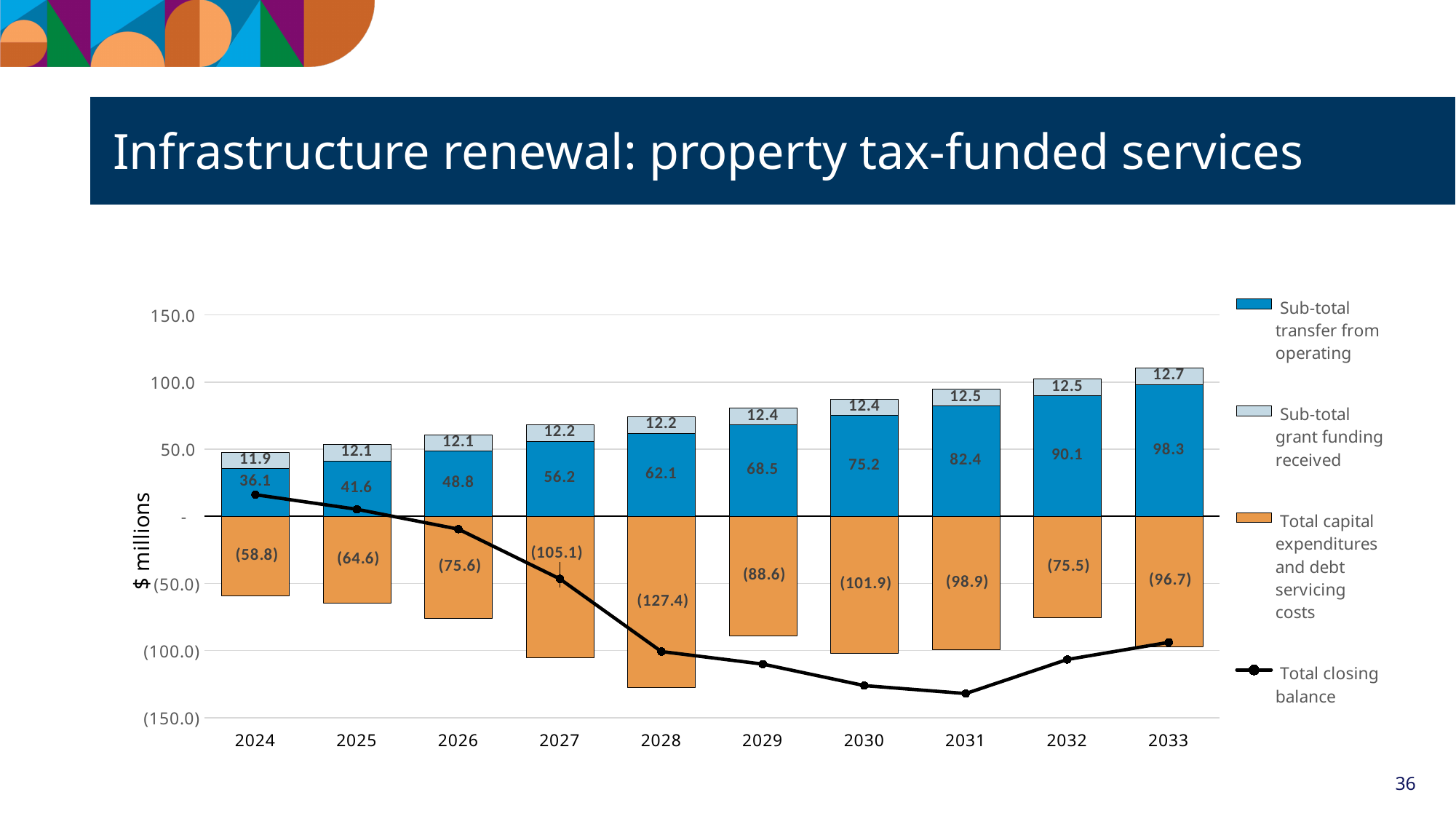
Which year has the larger Total capital expenditures and debt servicing costs, 2027 or 2030? 2027 What is the value of the Sub-total transfer from operating in 2030? 75.2 What is the value shown for Total capital expenditures and debt servicing costs in 2028? (127.4) What is the combined value of the Sub-total transfer from operating and Sub-total grant funding received in 2033? 111.0 How many years are shown on the x axis? 10 How many series does the legend list? 4 By how much does the Sub-total transfer from operating in 2033 exceed that in 2024? 62.2 In which year are Total capital expenditures and debt servicing costs the largest in magnitude? 2028 What is the Sub-total grant funding received in 2033? 12.7 Is the Total closing balance in 2031 greater or less than (100.0)? less In which year is the Sub-total transfer from operating the smallest? 2024 What kind of chart is shown on the slide? Stacked bar chart with a line